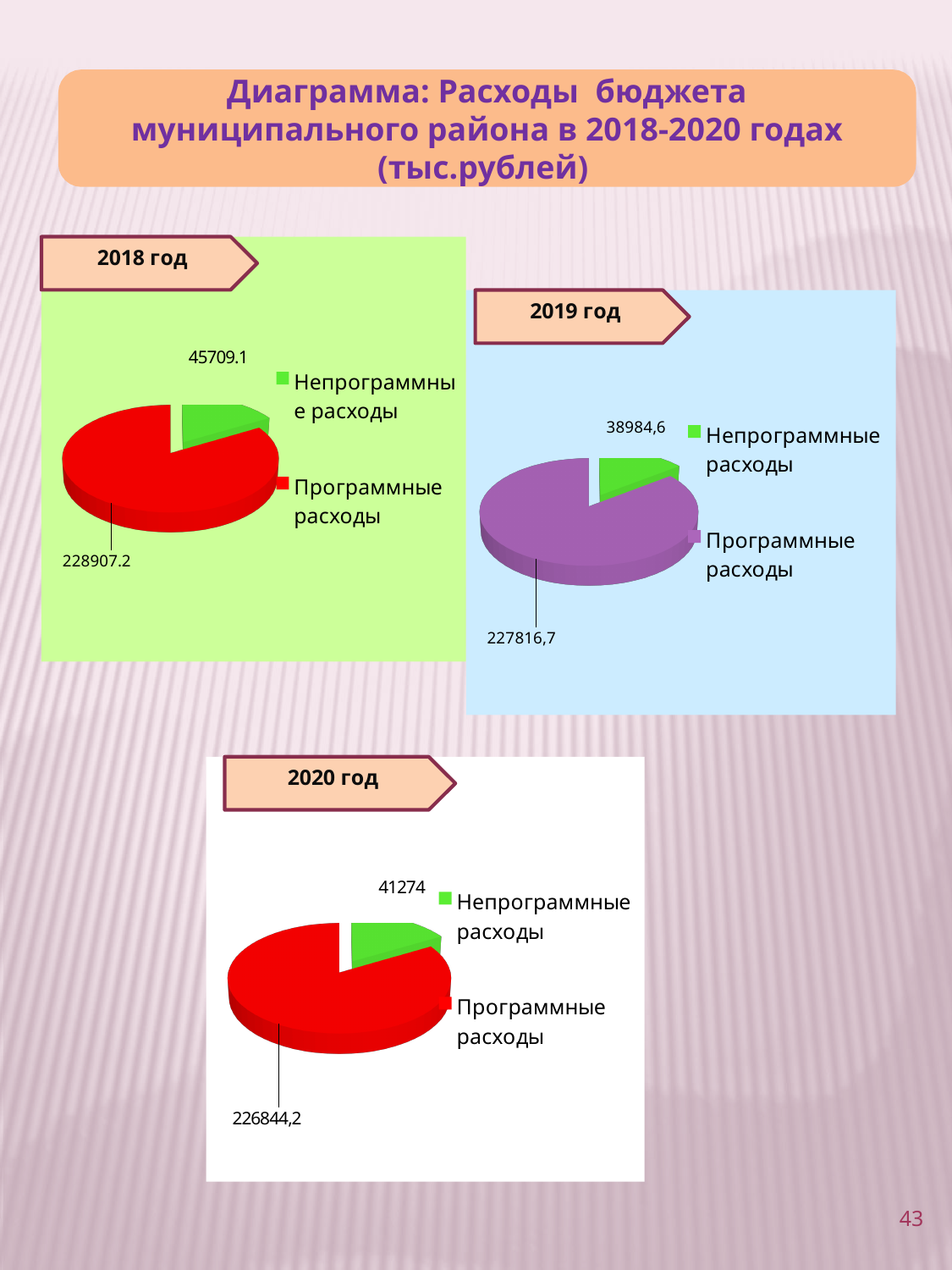
On the 2020 год chart, what is the value for Непрограммные расходы? 41274 On the 2019 год chart, which category has the smallest slice? Непрограммные расходы On the 2018 год chart, what is the value for Непрограммные расходы? 45709.1 On the 2020 год chart, what is the value for Программные расходы? 226844,2 On the 2018 год chart, what is the value for Программные расходы? 228907.2 What kind of chart is used for the 2019 год data? Pie chart How many categories does the 2020 год chart show? 2 On the 2019 год chart, what colour is the Программные расходы slice? Purple On the 2020 год chart, which category has the largest slice? Программные расходы On the 2018 год chart, what is the difference between Программные расходы and Непрограммные расходы? 183198.1 On the 2019 год chart, what is the value for Программные расходы? 227816,7 On the 2019 год chart, what is the value for Непрограммные расходы? 38984,6